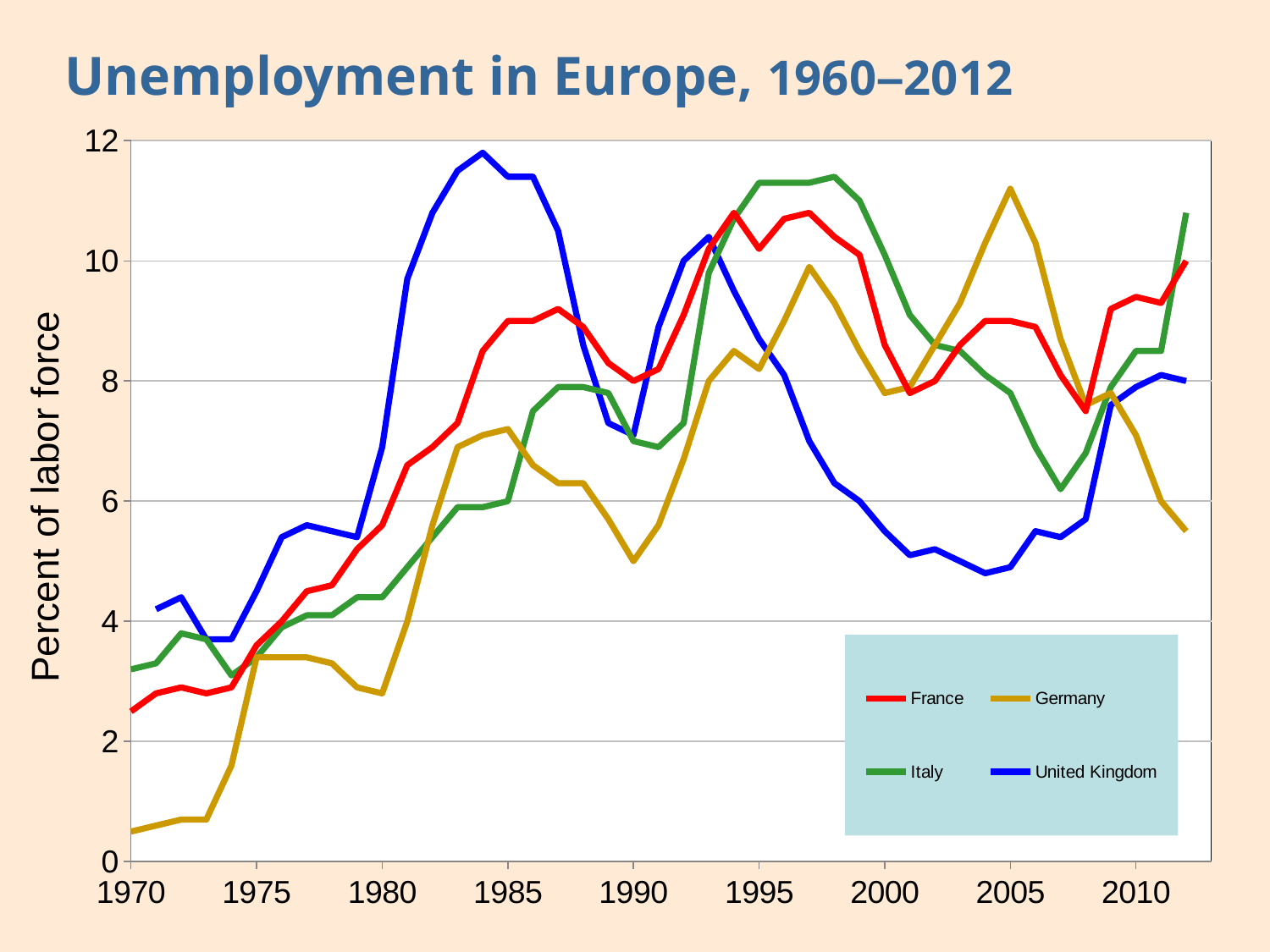
In 2005, which is higher: Germany or the United Kingdom? Germany Is the value for Germany in 1970 greater or less than 2? less What is the title of the chart? Unemployment in Europe, 1960–2012 Which series has the lowest value in 1970? Germany Is the value for the United Kingdom in 2004 greater or less than 6? less What is the label on the vertical axis? Percent of labor force Which series has the highest value in 1984? United Kingdom Is the value for the United Kingdom in 1984 greater or less than 10? greater How many series does the legend list? 4 What kind of chart is shown on the slide? line chart Does the value for Germany rise or fall from 2005 to 2012? fall